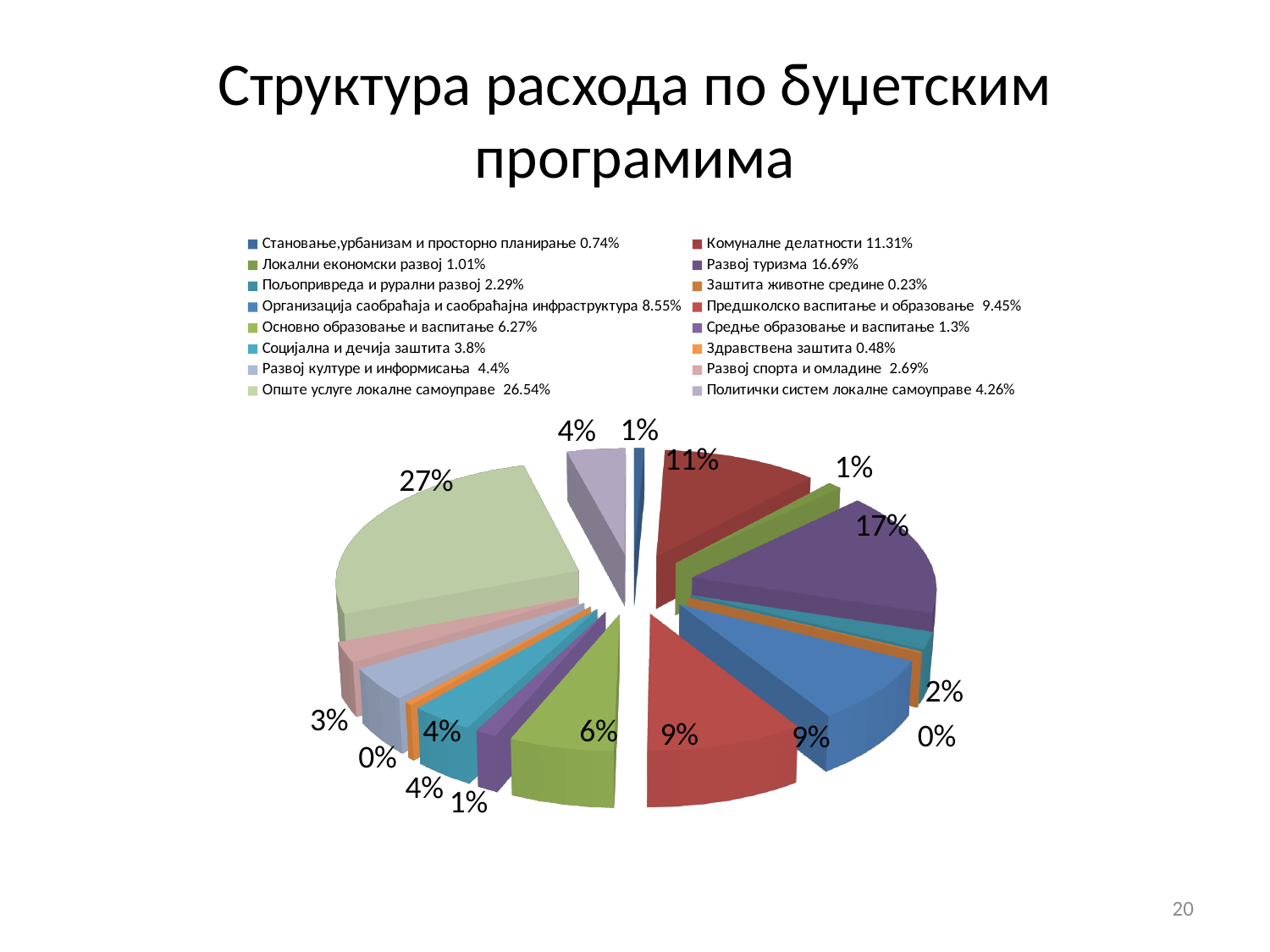
What is the title of the slide's chart? Структура расхода по буџетским програмима What is the difference in percentage points between Опште услуге локалне самоуправе and Развој туризма, using the legend values? 9.85 What rounded data label is printed on the largest slice of the pie? 27% What percentage is shown in the legend for Комуналне делатности? 11.31% What percentage is shown in the legend for Социјална и дечија заштита? 3.8% What percentage is shown in the legend for Предшколско васпитање и образовање? 9.45% Which category has the largest share of the pie? Опште услуге локалне самоуправе What percentage is shown in the legend for Развој туризма? 16.69% Which category has the smallest share of the pie? Заштита животне средине Which has a larger share: Развој туризма or Комуналне делатности? Развој туризма How many categories does the legend of the pie chart list? 16 What kind of chart is shown on the slide? pie chart